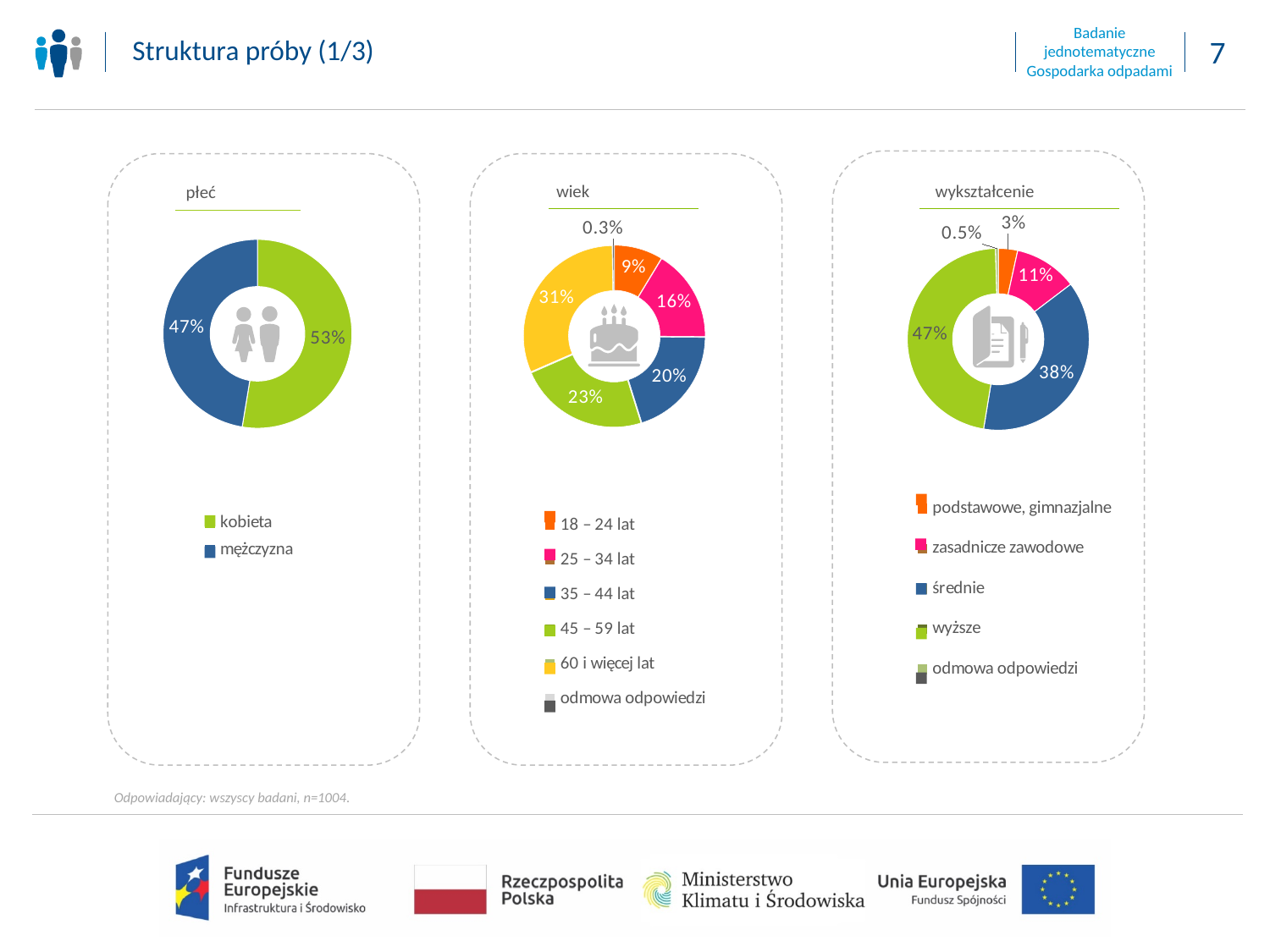
In the 'wykształcenie' chart, what share is shown for odmowa odpowiedzi? 0.5% In the 'wykształcenie' chart, which category has the largest share? wyższe In the 'płeć' chart, what share is labelled for mężczyzna? 47% How many categories does the legend of the 'wiek' chart list? 6 In the 'wiek' chart, what share is shown for 35 – 44 lat? 20% What type of chart is used for the 'płeć' data? pie (donut) chart In the 'wiek' chart, which age group has the smallest share? odmowa odpowiedzi In the 'płeć' chart, which category has the larger share, kobieta or mężczyzna? kobieta In the 'płeć' chart, what share is labelled for kobieta? 53% In the 'wiek' chart, what share is shown for 60 i więcej lat? 31% In the 'wiek' chart, what is the difference between the shares for 45 – 59 lat and 18 – 24 lat? 14% In the 'wykształcenie' chart, what share is shown for średnie? 38%